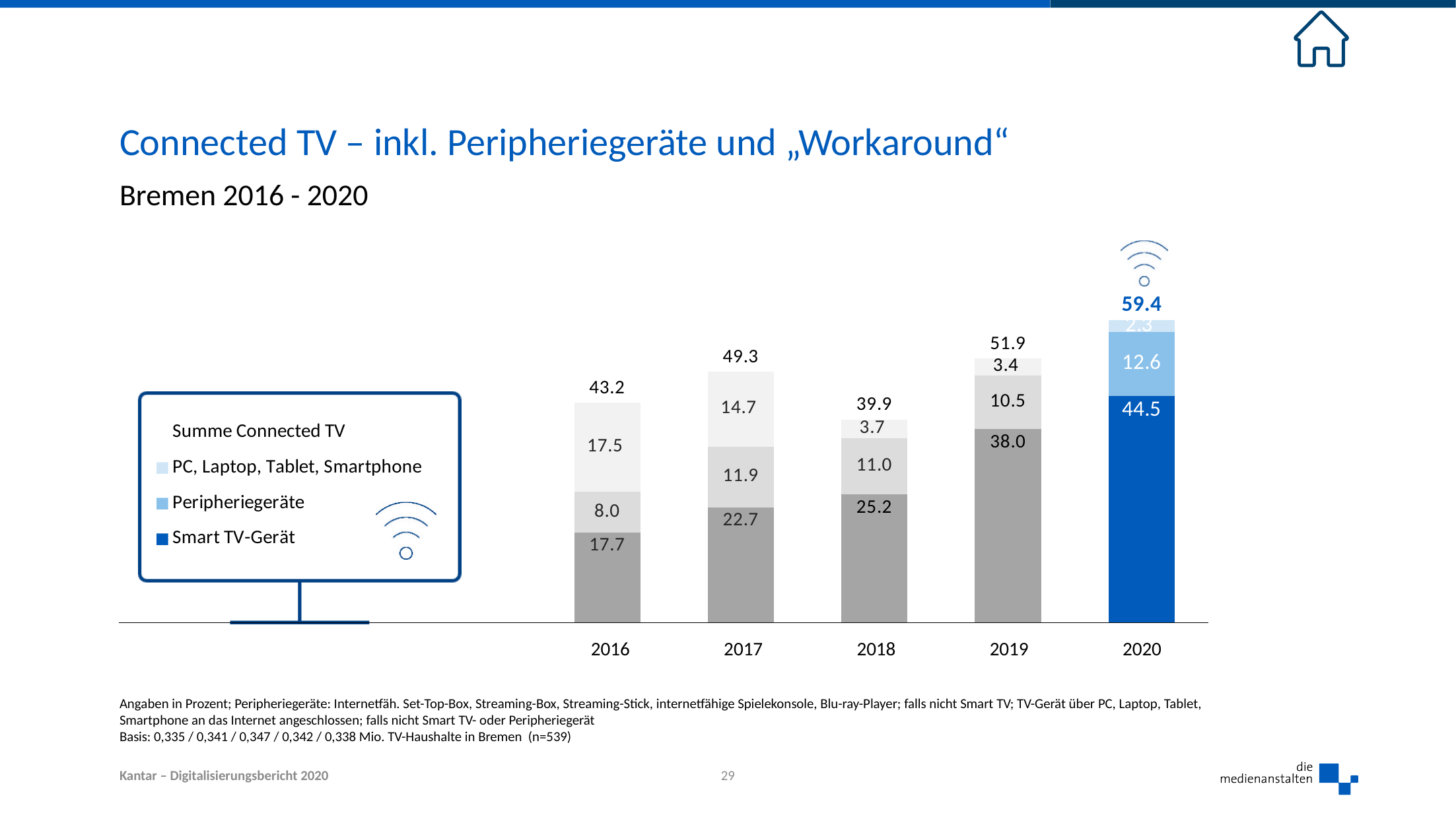
What is the Smart TV-Gerät value for 2020? 44.5 Which year has the lowest Summe Connected TV total? 2018 What is the total Summe Connected TV value for 2019? 51.9 What is the difference between the Smart TV-Gerät values for 2019 and 2018? 12.8 How many years are shown on the x axis? 5 Which is larger, the Peripheriegeräte value for 2018 or for 2019? 2018 Which year has the highest Summe Connected TV total? 2020 What is the Peripheriegeräte value for 2017? 11.9 How many series does the legend list with a colour swatch? 3 What type of chart is shown on the slide? stacked bar chart What is the PC, Laptop, Tablet, Smartphone value for 2016? 17.5 Does the Smart TV-Gerät value rise or fall from 2016 to 2020? rise